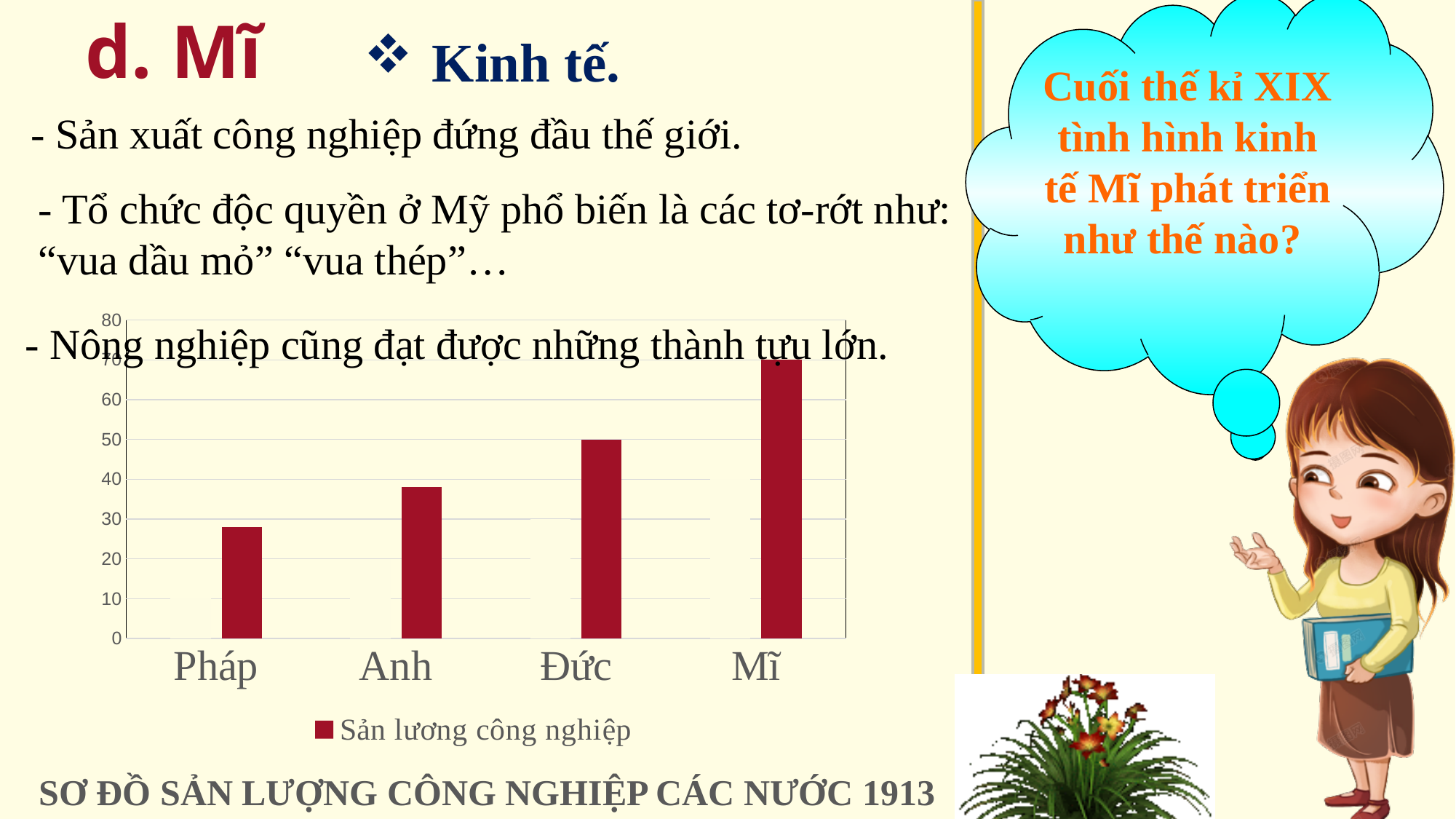
Is the value for Anh greater or less than 40? less What is the value for Đức in the chart? 50 Do the bar values rise or fall from Pháp to Mĩ along the x axis? rise How many countries are shown on the x axis of the chart? 4 How many series does the chart legend list? 1 Which is larger, the value for Anh or the value for Đức? Đức Which country has the lowest bar in the chart? Pháp Is the value for Pháp greater or less than 30? less Is the value for Mĩ greater or less than 60? greater What is the legend entry of the series in the chart? Sản lương công nghiệp What kind of chart is shown on the slide? bar chart Which country has the highest bar in the chart? Mĩ